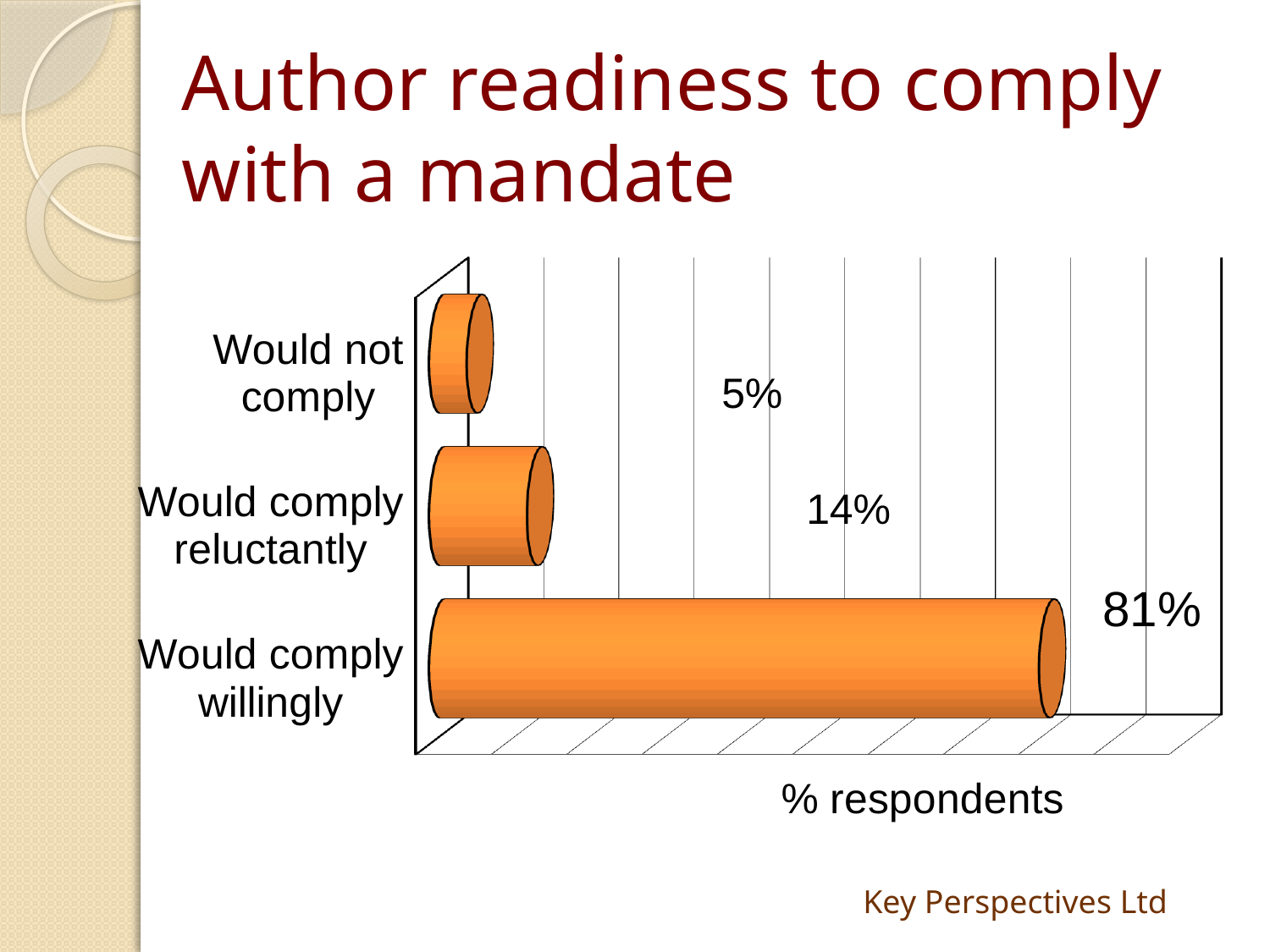
Which category has the lowest percentage of respondents? Would not comply What is the label on the horizontal axis of the chart? % respondents What percentage of respondents would comply willingly with a mandate? 81% What kind of chart is shown on the slide? Bar chart What percentage of respondents would comply reluctantly? 14% How many categories are shown in the chart? 3 What percentage of respondents would not comply? 5% Which category has the highest percentage of respondents? Would comply willingly What is the difference in percentage points between 'Would comply willingly' and 'Would comply reluctantly'? 67 What is the title of the slide containing the chart? Author readiness to comply with a mandate Which is larger: the percentage that would comply reluctantly or the percentage that would not comply? Would comply reluctantly What is the difference in percentage points between 'Would comply reluctantly' and 'Would not comply'? 9